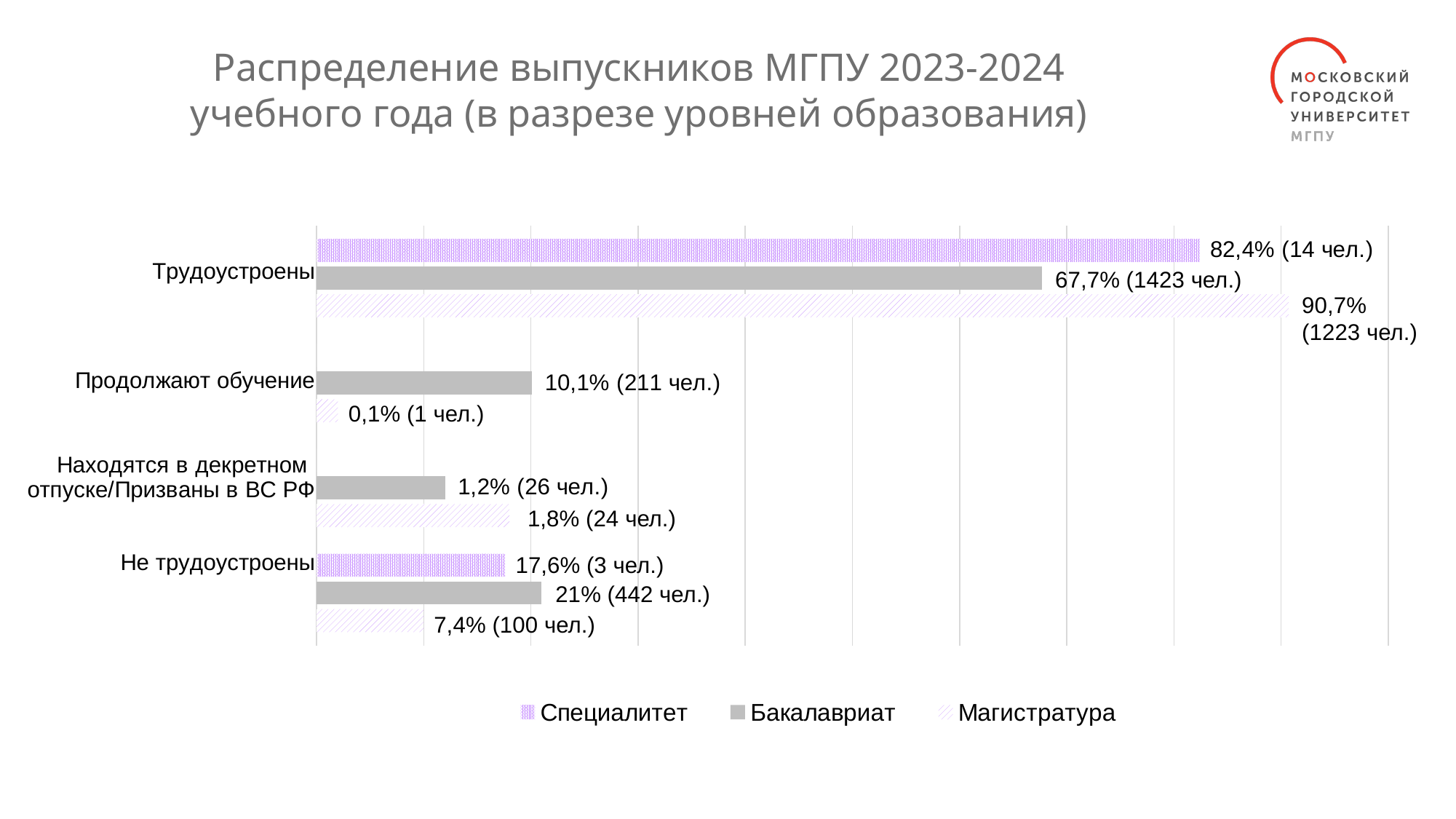
How many series does the legend list? 3 What is the difference in percentage points between Магистратура and Бакалавриат in the category Трудоустроены? 23 percentage points How many categories are shown on the vertical axis of the chart? 4 Which is larger in the category Не трудоустроены: the percentage for Бакалавриат or for Магистратура? Бакалавриат What is the value for Магистратура in the category Трудоустроены? 90,7% (1223 чел.) What type of chart is shown on the slide? Bar chart What is the value for Магистратура in the category Продолжают обучение? 0,1% (1 чел.) What is the title of the chart on the slide? Распределение выпускников МГПУ 2023-2024 учебного года (в разрезе уровней образования) Which series has the highest percentage in the category Трудоустроены? Магистратура What is the value for Специалитет in the category Не трудоустроены? 17,6% (3 чел.) What is the value for Бакалавриат in the category Трудоустроены? 67,7% (1423 чел.) Which series has the lowest percentage in the category Не трудоустроены? Магистратура